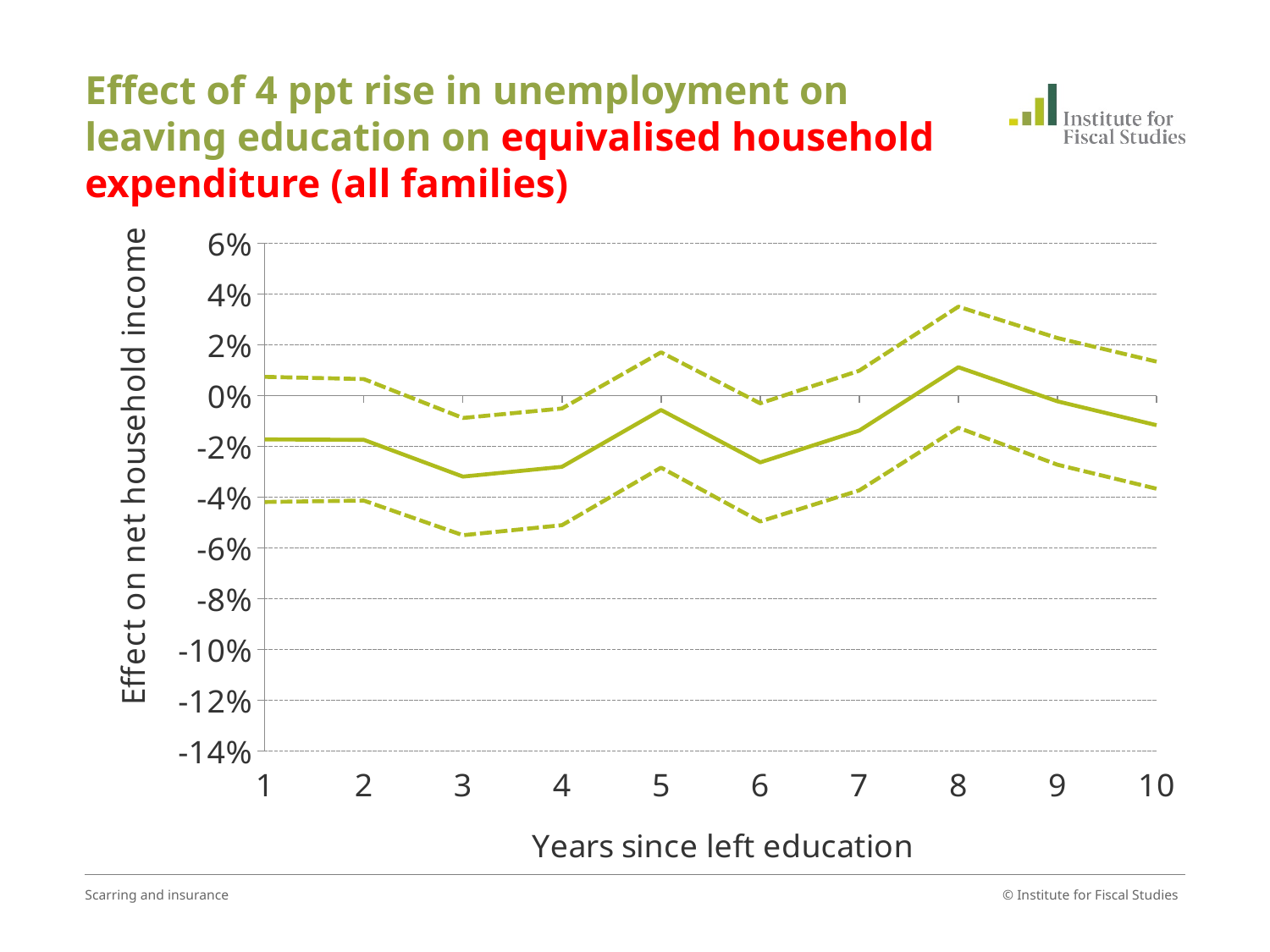
How many lines are plotted on the chart? 3 On the solid line, which is higher: the value at year 5 or the value at year 6? year 5 What kind of chart is shown on the slide? line chart What is the label of the x axis? Years since left education Does the solid line rise or fall between year 6 and year 8? rise How many points are shown along the x axis (years since left education)? 10 Is the value of the upper dashed line at year 8 greater or less than 2%? greater At which year since leaving education does the solid line reach its lowest value? 3 Is the value of the lower dashed line at year 3 greater or less than -4%? less Is the value of the solid line at year 3 greater or less than -2%? less At which year since leaving education does the solid line reach its highest value? 8